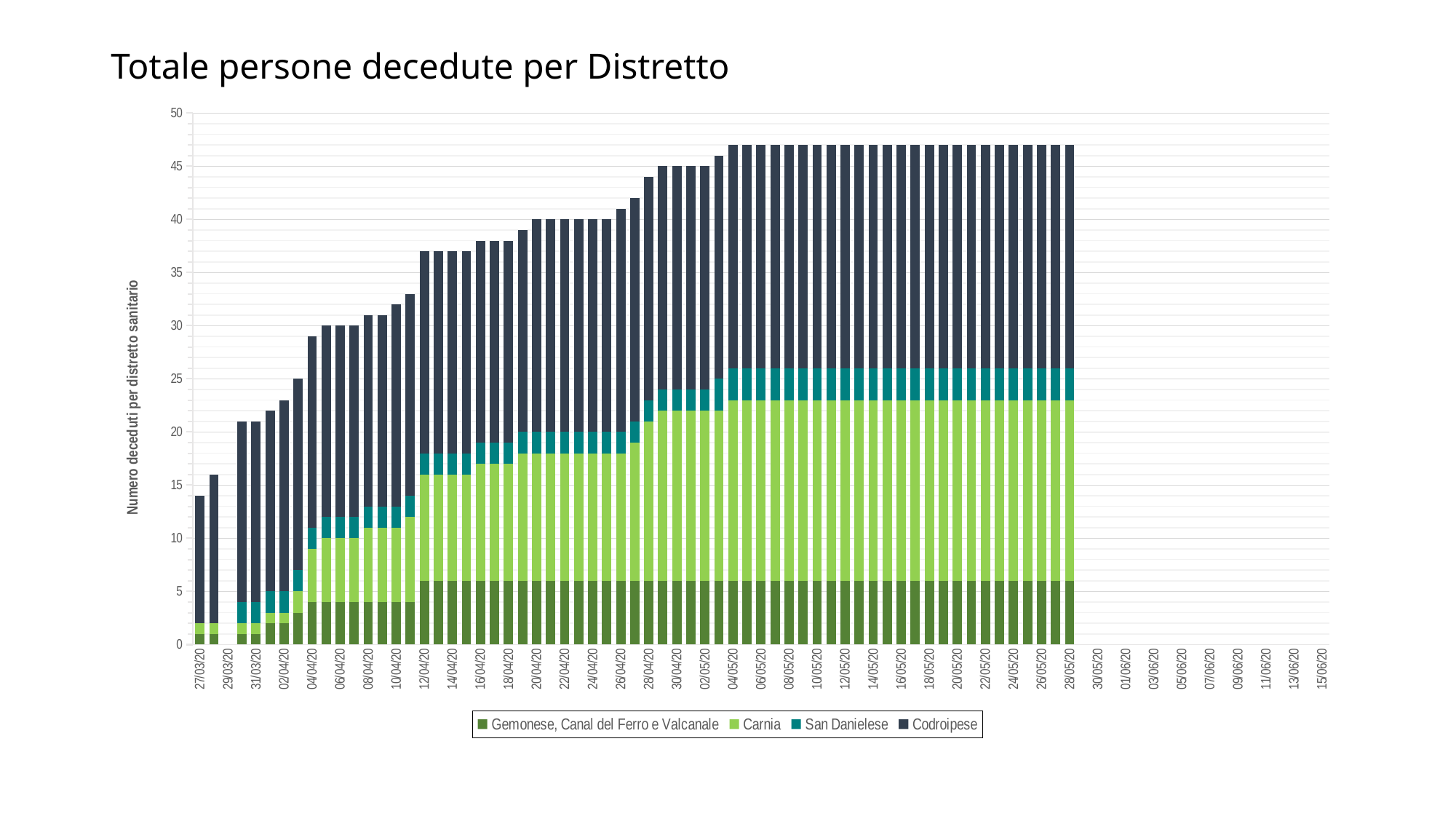
Which total is larger, 27/03/20 or 28/05/20? 28/05/20 What is the total bar value on 20/04/20? 40 Is the Carnia segment on 28/05/20 greater or less than 15? greater Do the total values generally rise or fall from 27/03/20 to 28/05/20? rise Is the total for 28/05/20 greater or less than 45? greater On 28/05/20, which segment is larger, Codroipese or Carnia? Codroipese What is the title of the chart? Totale persone decedute per Distretto Which date has the lowest total bar? 27/03/20 What type of chart is shown on the slide? Stacked bar chart Which series is shown in the darkest colour at the top of each bar? Codroipese Is the total for 27/03/20 greater or less than 20? less How many series does the legend list? 4